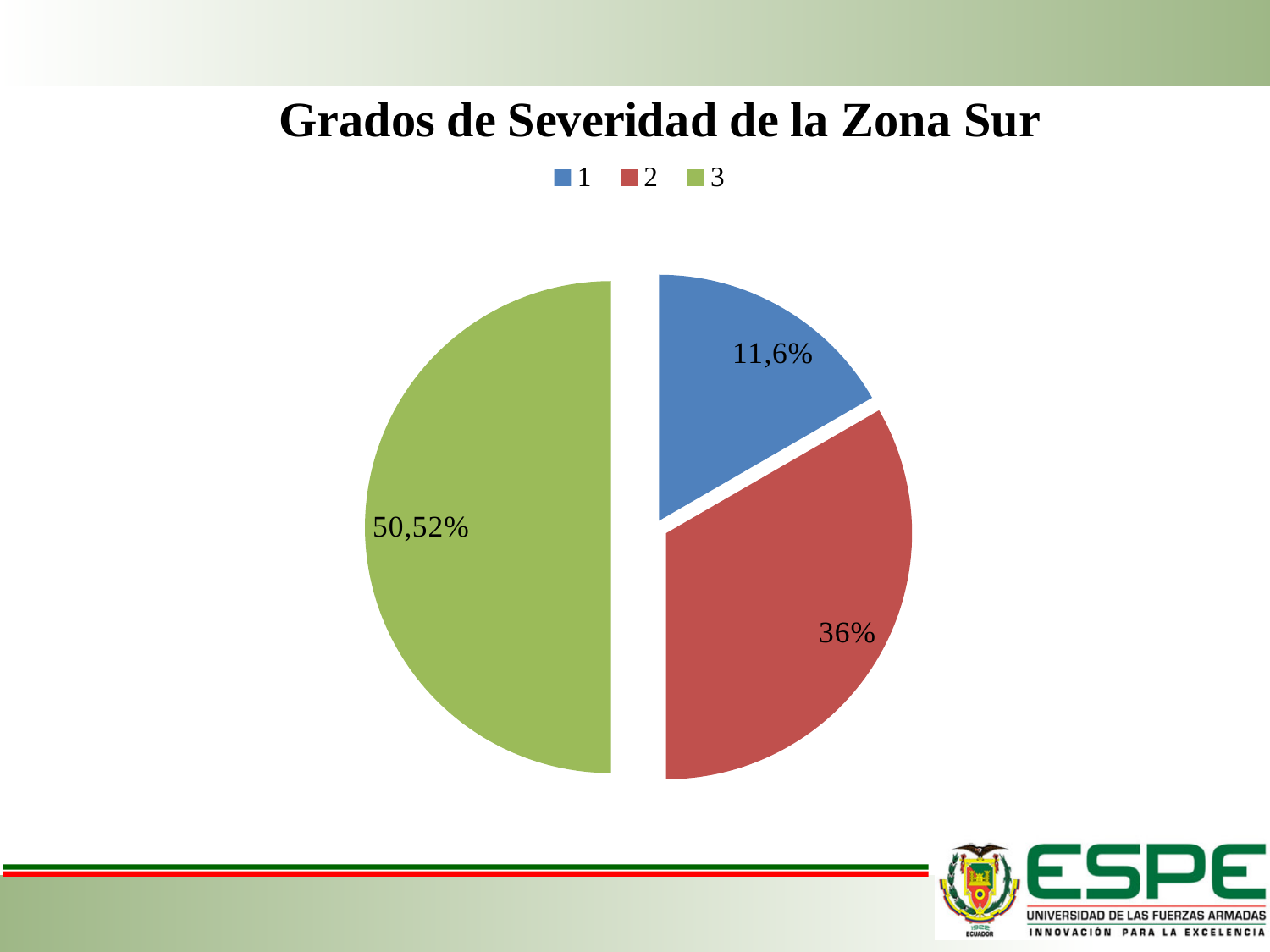
What percentage does the slice for category 3 show? 50,52% What kind of chart is shown on the slide? pie chart What percentage does the slice for category 1 show? 11,6% What percentage does the slice for category 2 show? 36% Which category has the largest slice of the pie? 3 Which is larger, the slice for category 2 or the slice for category 1? 2 What is the title of the chart? Grados de Severidad de la Zona Sur How many slices does the pie chart have? 3 What is the difference between the percentage for category 3 and the percentage for category 2? 14,52% What colour is the slice for category 3? green Which category has the smallest slice of the pie? 1 How many entries does the legend list? 3